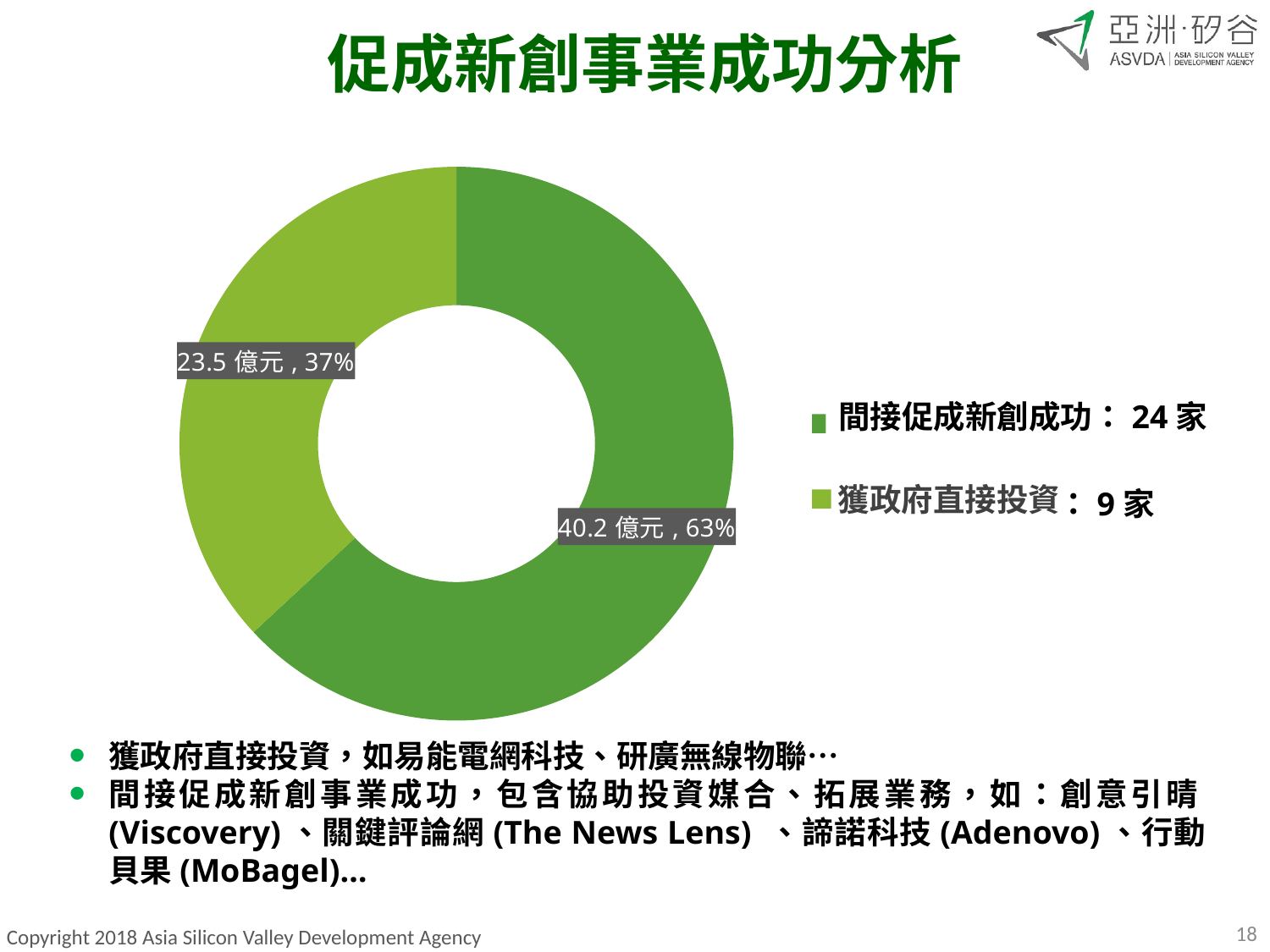
What is the difference in 億元 between the 間接促成新創成功 slice and the 獲政府直接投資 slice? 16.7 億元 Which slice is the largest? 間接促成新創成功 What share of the donut does 間接促成新創成功 represent? 63% Which is larger, the value for 間接促成新創成功 or the value for 獲政府直接投資? 間接促成新創成功 What value is labelled on the slice for 獲政府直接投資？ 23.5 億元 How many companies does the legend give for 獲政府直接投資? 9 家 Which slice is the smallest? 獲政府直接投資 How many entries does the legend list? 2 How many slices does the donut chart have? 2 What share of the donut does 獲政府直接投資 represent? 37% What kind of chart is shown on the slide? Donut (pie) chart What value is labelled on the slice for 間接促成新創成功？ 40.2 億元